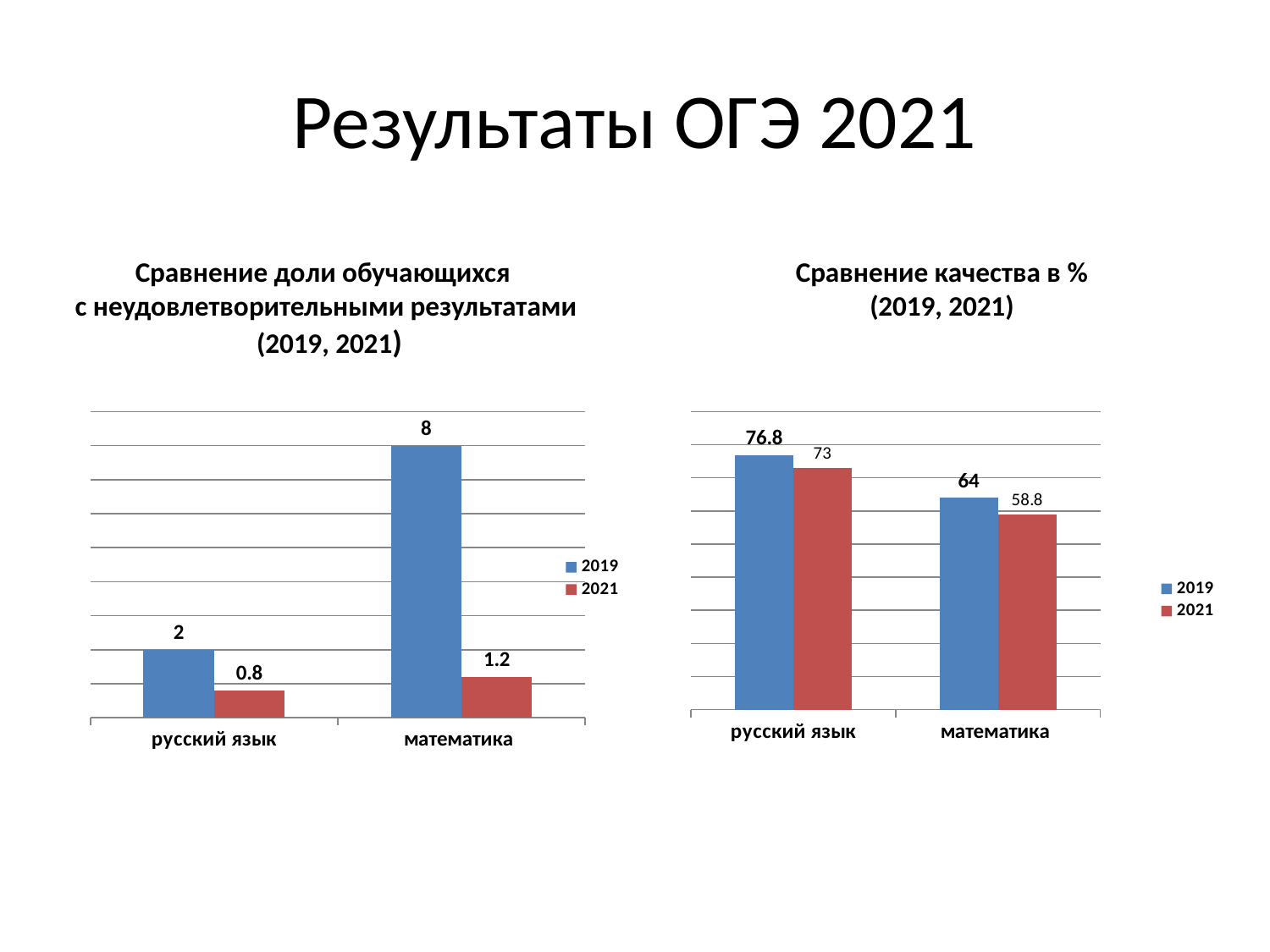
In the right chart (Сравнение качества в %), what is the value for математика in 2021? 58.8 How many categories are shown on the x axis of the right chart (Сравнение качества в %)? 2 In the right chart (Сравнение качества в %), what is the difference between the 2019 and 2021 values for русский язык? 3.8 What kind of chart is the left chart (Сравнение доли обучающихся с неудовлетворительными результатами)? bar chart In the left chart (Сравнение доли обучающихся с неудовлетворительными результатами), what is the value for математика in 2019? 8 In the left chart (Сравнение доли обучающихся с неудовлетворительными результатами), what is the value for русский язык in 2021? 0.8 In the left chart (Сравнение доли обучающихся с неудовлетворительными результатами), what is the difference between the 2019 and 2021 values for математика? 6.8 In the left chart (Сравнение доли обучающихся с неудовлетворительными результатами), which bar is the lowest? русский язык, 2021 In the left chart (Сравнение доли обучающихся с неудовлетворительными результатами), which bar is the highest? математика, 2019 In the right chart (Сравнение качества в %), which is larger: the 2019 value for математика or the 2021 value for русский язык? 2021 value for русский язык In the right chart (Сравнение качества в %), what is the value for русский язык in 2019? 76.8 How many series does the legend of the right chart (Сравнение качества в %) list? 2